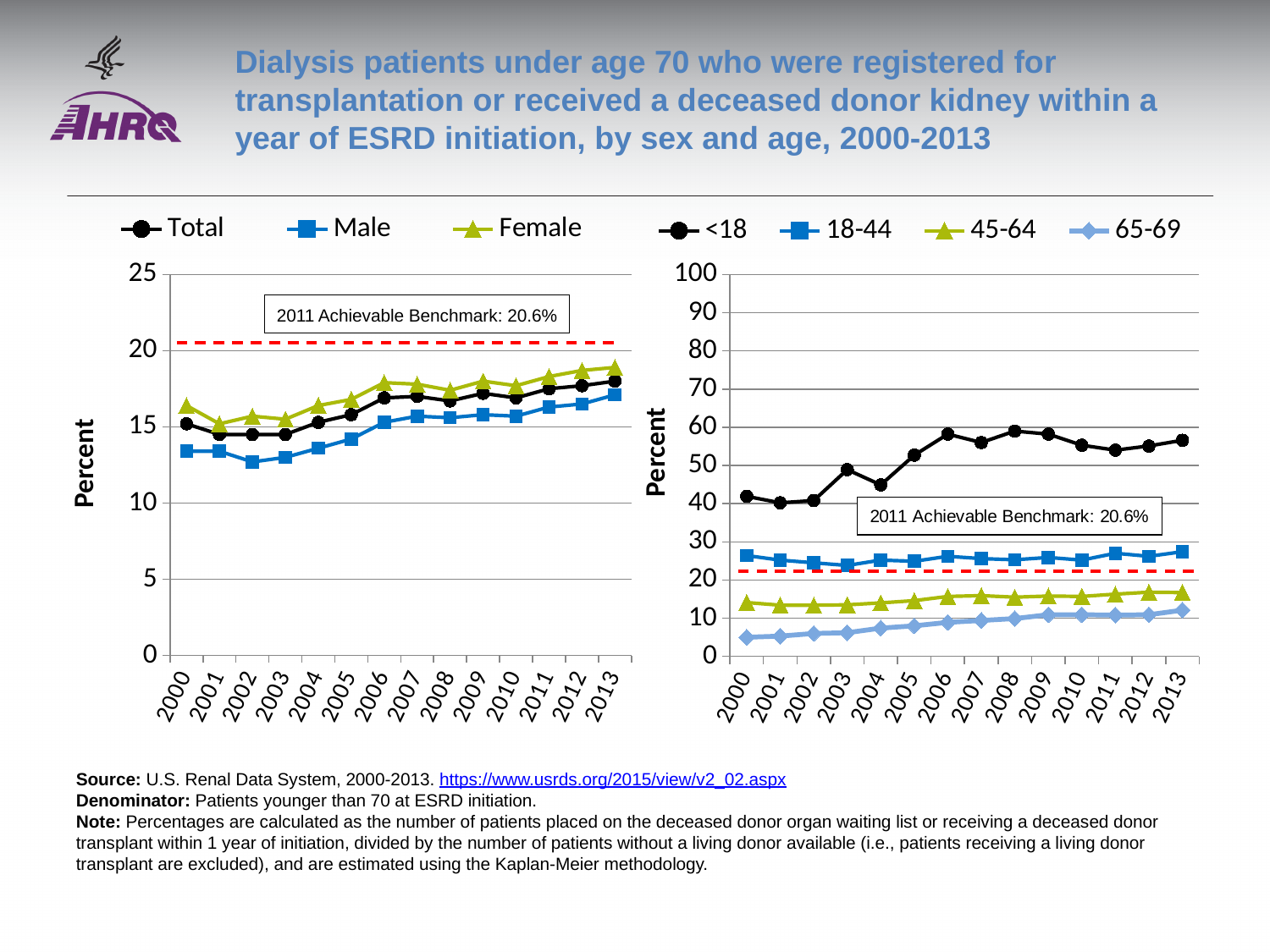
In the right chart (by age), is the value for <18 in 2008 greater or less than 50? greater What is the 2011 Achievable Benchmark shown on the charts? 20.6% What type of chart is the left chart (by sex)? line chart In the right chart (by age), which age group has the lowest values across the years? 65-69 In the right chart (by age), do the values for the 65-69 group rise or fall from 2000 to 2013? rise In the left chart (by sex), which series has the highest values across the years? Female How many years are shown on the x axis of the left chart (by sex)? 14 In the left chart (by sex), is the value for Male in 2002 greater or less than 15? less How many series does the legend of the right chart (by age) list? 4 In the right chart (by age), which age group has the highest values across the years? <18 In the left chart (by sex), is the value for Total in 2013 greater or less than 20? less In the left chart (by sex), which series has the lowest values across the years? Male